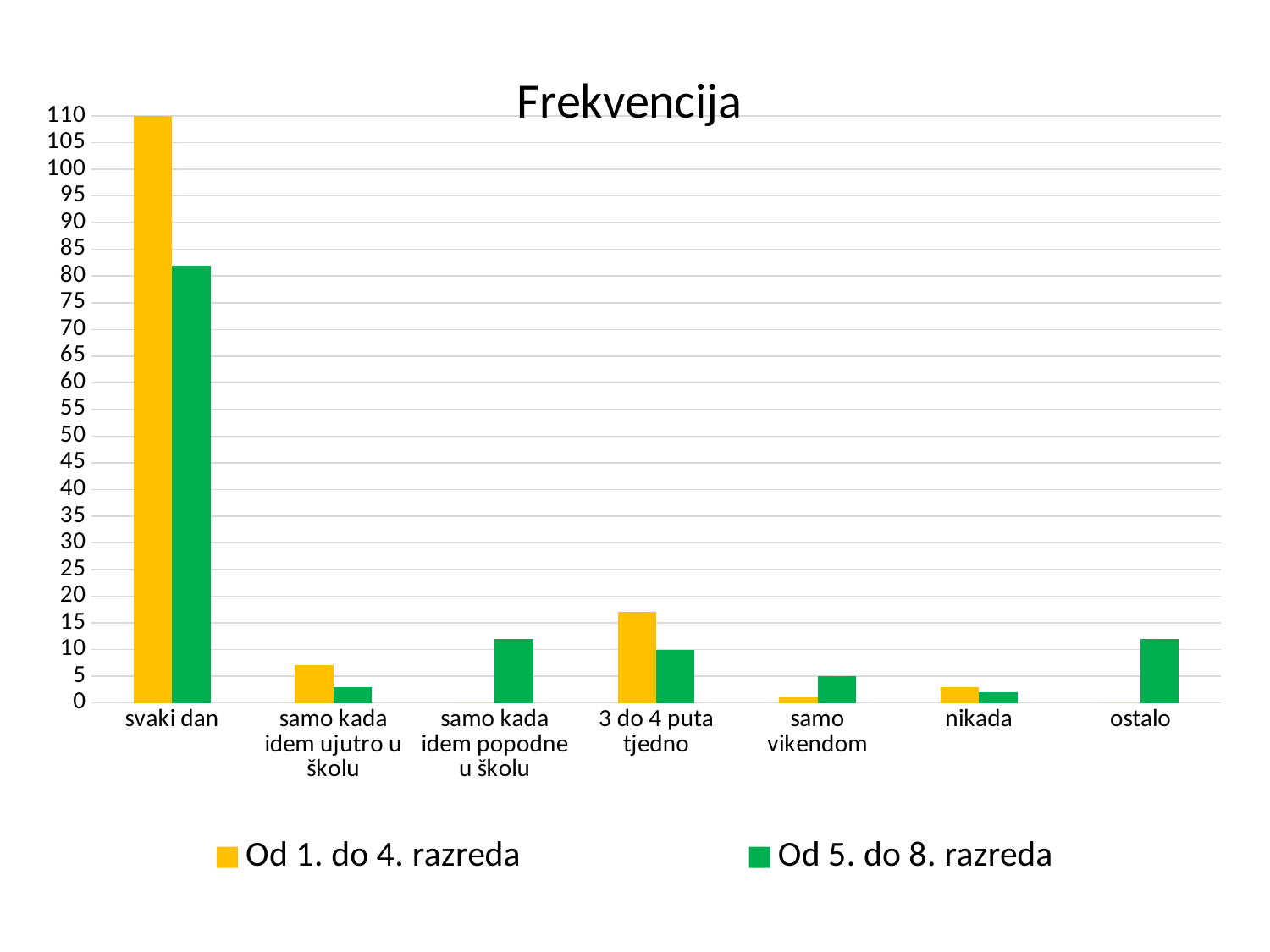
What is the value for '3 do 4 puta tjedno' in the 'Od 5. do 8. razreda' series? 10 For 'svaki dan', which series has the larger value? Od 1. do 4. razreda Which category has the highest value in the 'Od 1. do 4. razreda' series? svaki dan What kind of chart is shown on the slide? bar chart Is the value for '3 do 4 puta tjedno' in the 'Od 1. do 4. razreda' series greater or less than 15? greater Is the value for 'svaki dan' in the 'Od 5. do 8. razreda' series greater or less than 80? greater What is the value for 'svaki dan' in the 'Od 1. do 4. razreda' series? 110 How many series does the legend list? 2 What is the value for 'samo vikendom' in the 'Od 5. do 8. razreda' series? 5 For 'samo kada idem popodne u školu', which series has the larger value? Od 5. do 8. razreda What is the title of the chart? Frekvencija How many categories are shown on the x axis? 7